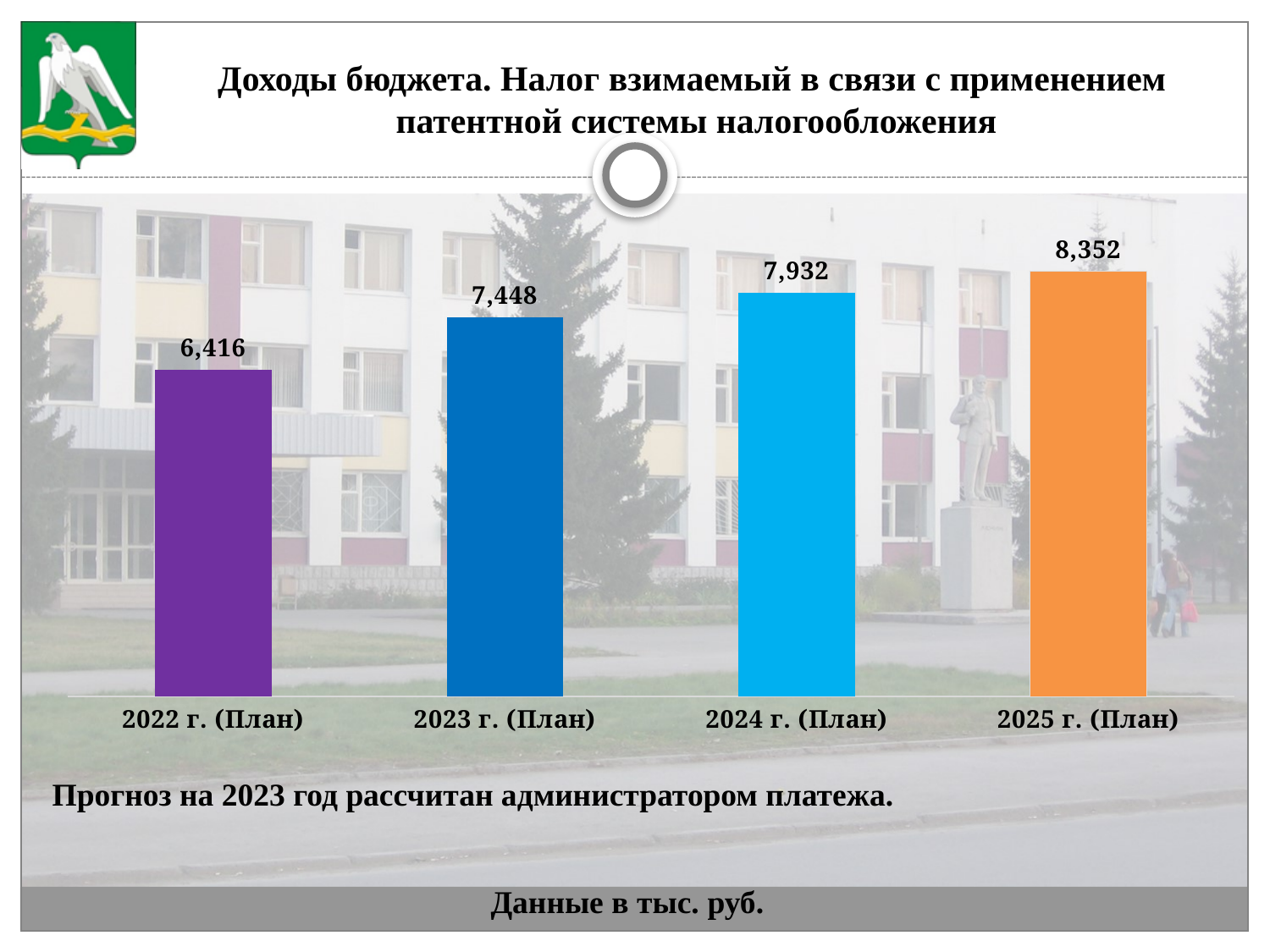
How many categories are shown in the chart? 4 What is the value for 2023 г. (План)? 7,448 What is the value for 2024 г. (План)? 7,932 Which category has the highest value? 2025 г. (План) What is the value for 2025 г. (План)? 8,352 What kind of chart is shown on the slide? Bar chart Which category has the lowest value? 2022 г. (План) What is the value for 2022 г. (План)? 6,416 What is the difference between the values for 2023 г. (План) and 2022 г. (План)? 1,032 Which is larger, the value for 2024 г. (План) or the value for 2023 г. (План)? 2024 г. (План) What is the difference between the values for 2025 г. (План) and 2024 г. (План)? 420 Do the values rise or fall from 2022 г. (План) to 2025 г. (План)? Rise